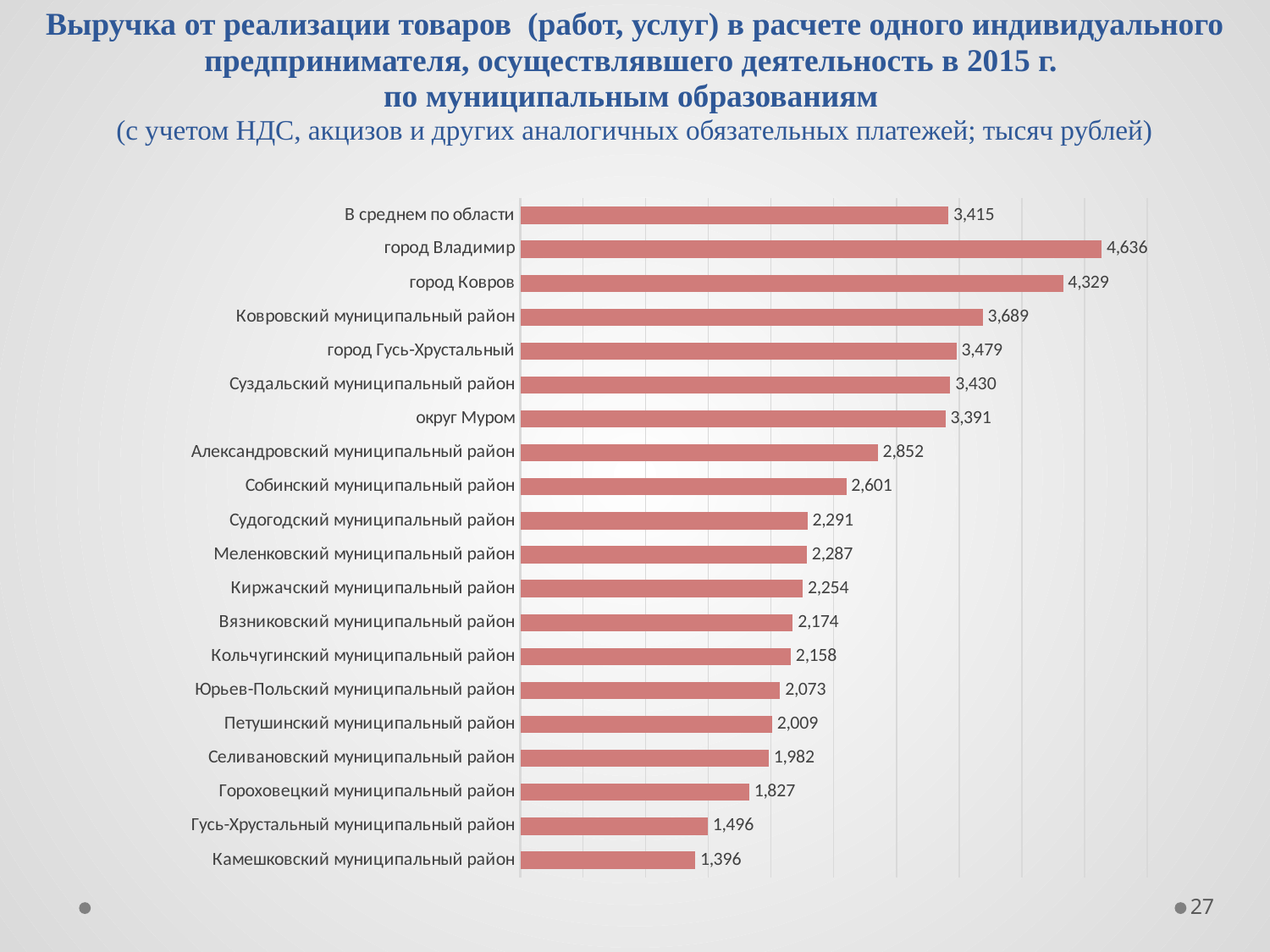
How many categories are shown in the chart? 20 Which category has the lowest value? Камешковский муниципальный район What type of chart is shown on the slide? bar chart What is the value for Камешковский муниципальный район? 1,396 What is the difference between the values for город Владимир and город Ковров? 307 What is the value for город Владимир? 4,636 What unit of measurement is stated in the chart's subtitle? тысяч рублей What is the difference between the values for Гусь-Хрустальный муниципальный район and Камешковский муниципальный район? 100 What is the value for округ Муром? 3,391 Which category has the highest value? город Владимир Which is larger, the value for Ковровский муниципальный район or the value for город Гусь-Хрустальный? Ковровский муниципальный район What is the value for В среднем по области? 3,415